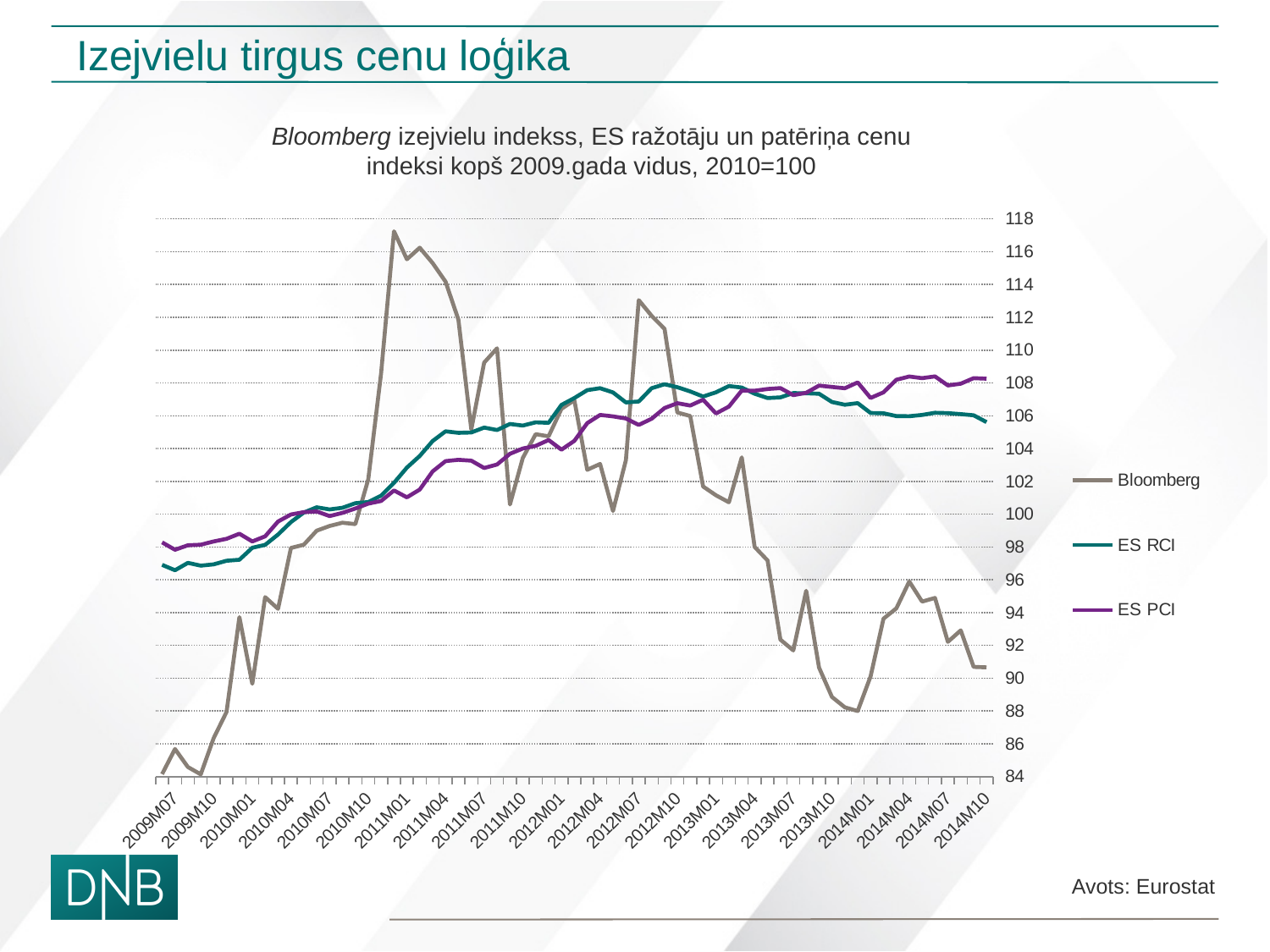
Which series has the lowest value at 2014M10? Bloomberg At 2011M01, which series is higher: Bloomberg or ES RCI? Bloomberg Is the Bloomberg value at 2011M01 greater or less than 114? greater What source is cited for the chart? Eurostat What kind of chart is shown on the slide? line chart What are the three series named in the legend? Bloomberg, ES RCI, ES PCI Is the ES PCI value at 2014M10 greater or less than 106? greater Does the Bloomberg series rise or fall between 2013M04 and 2014M01? fall How many series does the legend list? 3 At 2014M10, which series is higher: ES PCI or ES RCI? ES PCI